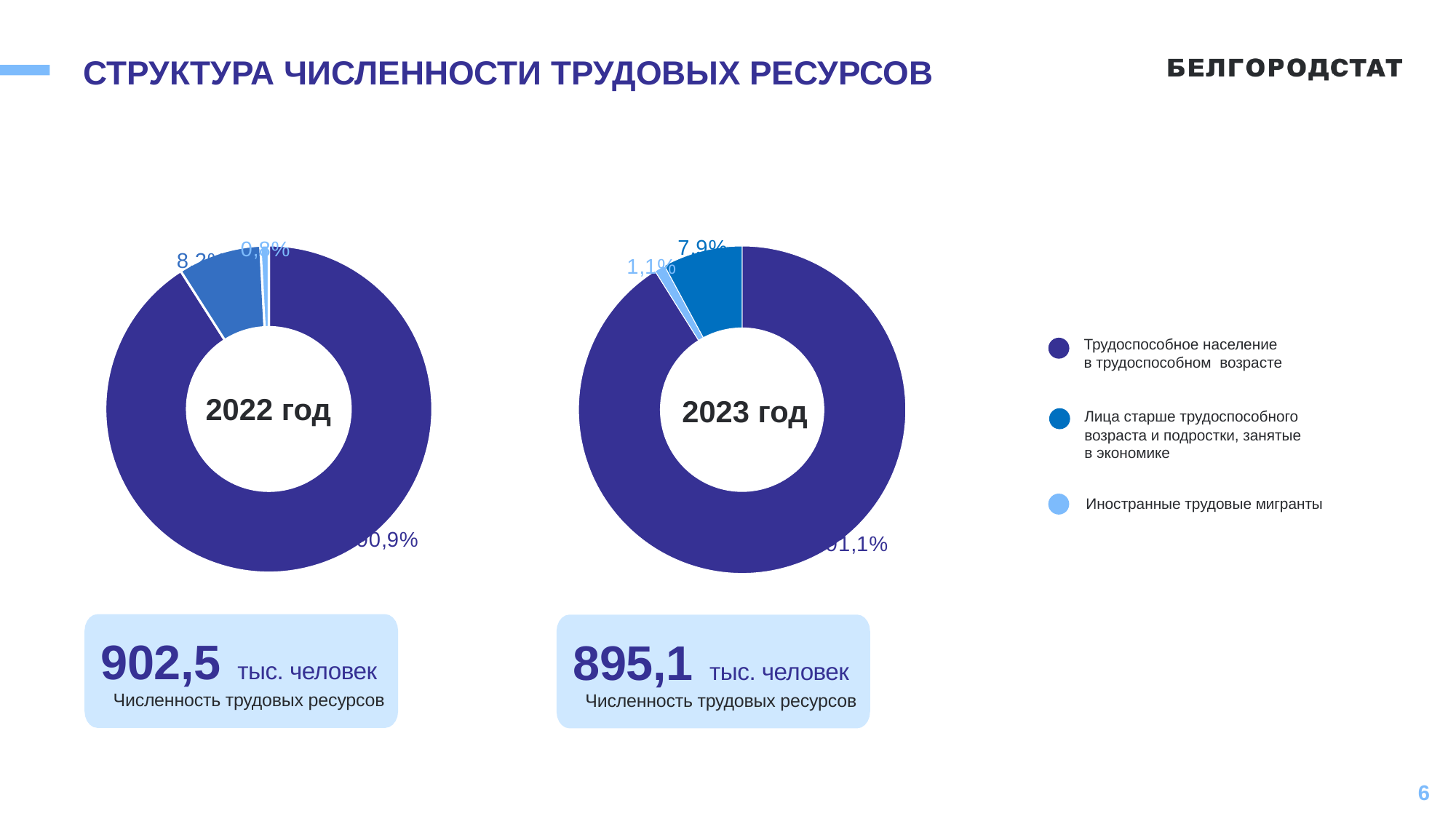
In the 2022 год chart, what share is shown for 'Лица старше трудоспособного возраста и подростки, занятые в экономике'? 8,2% In the 2022 год chart, which category has the largest slice? Трудоспособное население в трудоспособном возрасте How many categories does the legend list for the charts? 3 What total labour resources figure is shown beneath the 2022 год chart? 902,5 тыс. человек In the 2023 год chart, what share is shown for 'Лица старше трудоспособного возраста и подростки, занятые в экономике'? 7,9% In the 2023 год chart, which category has the smallest slice? Иностранные трудовые мигранты In the 2023 год chart, what share is shown for 'Иностранные трудовые мигранты'? 1,1% Is the share of 'Иностранные трудовые мигранты' larger in the 2022 год chart or the 2023 год chart? 2023 год What kind of chart is used to show the structure of labour resources for 2022 and 2023? pie chart (donut) How many slices does each donut chart contain? 3 In the 2022 год chart, what share is shown for 'Иностранные трудовые мигранты'? 0,8% By how many percentage points does the share of 'Лица старше трудоспособного возраста и подростки, занятые в экономике' differ between the 2022 год chart (8,2%) and the 2023 год chart (7,9%)? 0,3 percentage points